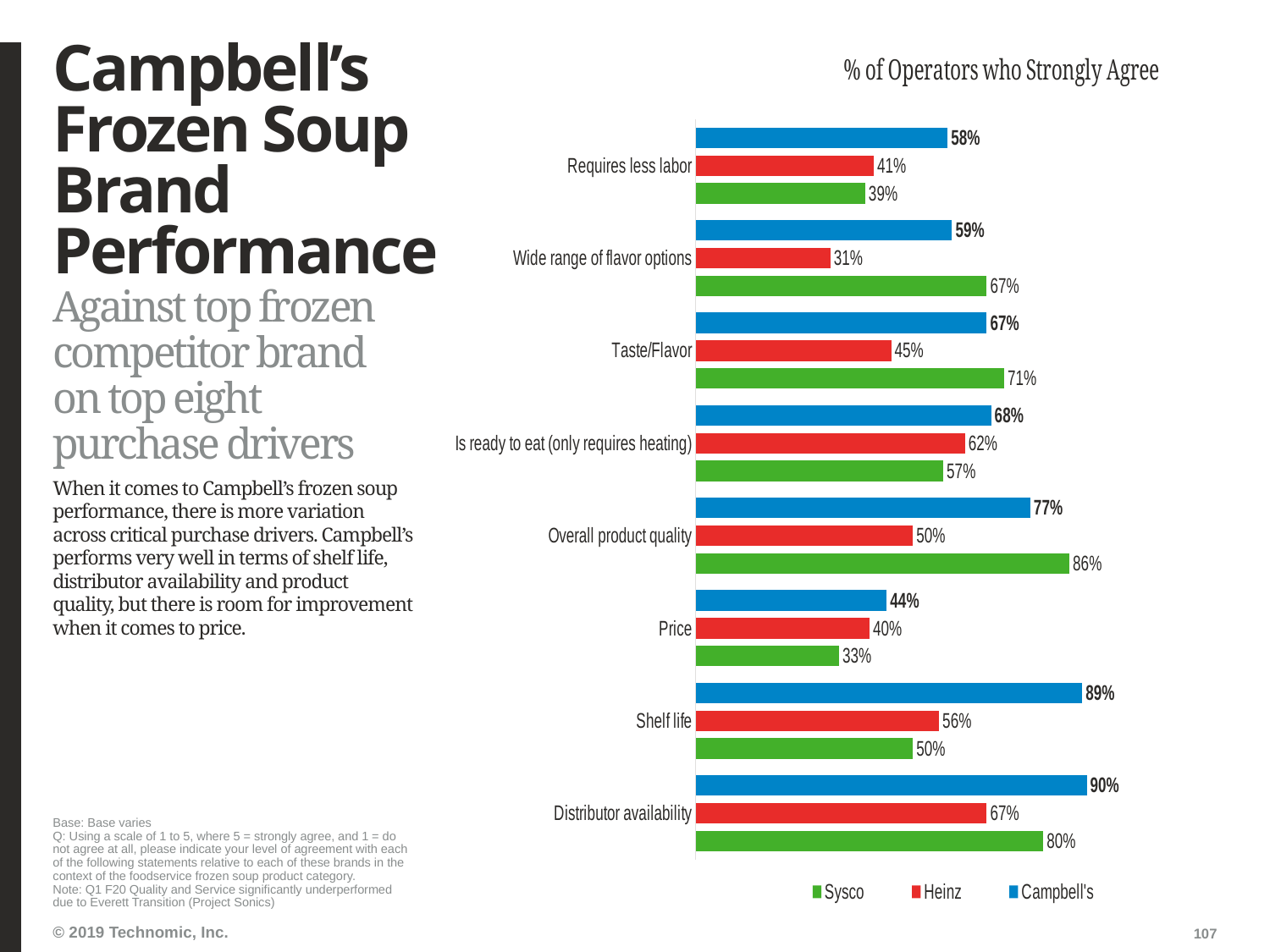
What is the difference between the Campbell's and Heinz values for Shelf life? 33% For Taste/Flavor, which brand has the higher value, Sysco or Campbell's? Sysco How many brands does the legend list? 3 How many purchase drivers are shown on the chart? 8 What is the Sysco value for Distributor availability? 80% For which purchase driver does Campbell's have its highest value? Distributor availability For which purchase driver does Heinz have its lowest value? Wide range of flavor options What type of chart is shown on the slide? Bar chart What percentage of operators strongly agree that Campbell's has a wide range of flavor options? 59% For Price, which brand has the higher value, Heinz or Sysco? Heinz What is the difference between the Sysco and Campbell's values for Overall product quality? 9% What is the Heinz value for Overall product quality? 50%